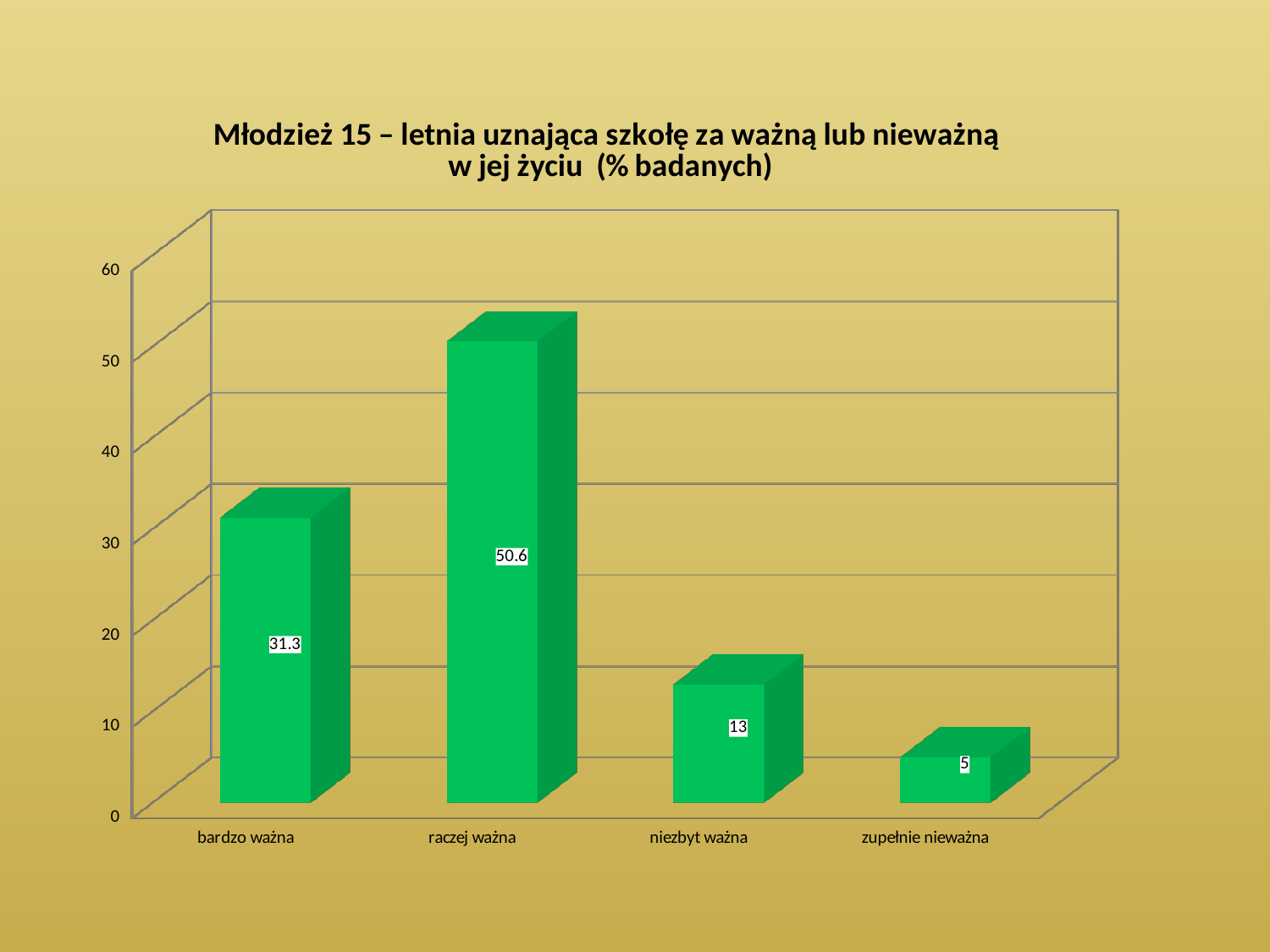
What is the value for "raczej ważna"? 50.6 What is the difference between the values for "niezbyt ważna" and "zupełnie nieważna"? 8 What is the title of the chart? Młodzież 15 – letnia uznająca szkołę za ważną lub nieważną w jej życiu (% badanych) What kind of chart is shown on the slide? bar chart Which category has the highest value? raczej ważna What is the value for "zupełnie nieważna"? 5 What is the value for "niezbyt ważna"? 13 Which is larger, the value for "bardzo ważna" or the value for "niezbyt ważna"? bardzo ważna Which category has the lowest value? zupełnie nieważna What is the difference between the values for "raczej ważna" and "bardzo ważna"? 19.3 How many categories are shown on the x axis? 4 What is the value for "bardzo ważna"? 31.3